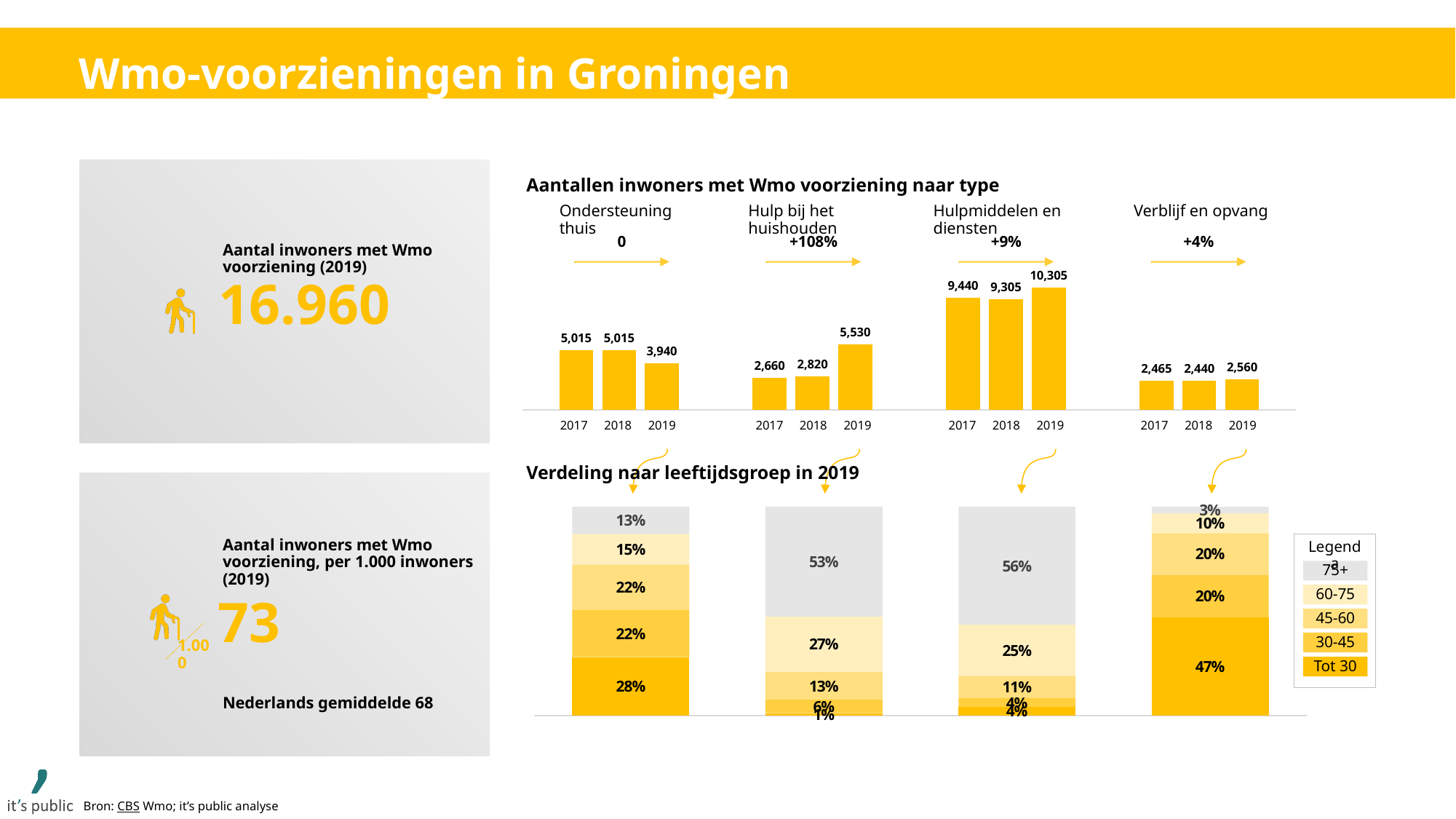
How many age groups does the legend of the 'Verdeling naar leeftijdsgroep in 2019' chart list? 5 In the 'Aantallen inwoners met Wmo voorziening naar type' chart, do the values for Ondersteuning thuis rise or fall from 2017 to 2019? fall In the 'Aantallen inwoners met Wmo voorziening naar type' chart, which year has the lowest value for Verblijf en opvang? 2018 In the 'Aantallen inwoners met Wmo voorziening naar type' chart, which is larger in 2019: Ondersteuning thuis or Hulp bij het huishouden? Hulp bij het huishouden In the 'Aantallen inwoners met Wmo voorziening naar type' chart, what is the value for Hulpmiddelen en diensten in 2019? 10,305 What kind of chart is 'Aantallen inwoners met Wmo voorziening naar type'? bar chart In the 'Aantallen inwoners met Wmo voorziening naar type' chart, what is the difference between the 2019 and 2017 values for Hulp bij het huishouden? 2,870 In the 'Aantallen inwoners met Wmo voorziening naar type' chart, what is the value for Hulp bij het huishouden in 2017? 2,660 In the 'Verdeling naar leeftijdsgroep in 2019' chart, what share of the Verblijf en opvang bar is the Tot 30 age group? 47% In the 'Aantallen inwoners met Wmo voorziening naar type' chart, what percentage change is shown above Hulp bij het huishouden? +108% In the 'Aantallen inwoners met Wmo voorziening naar type' chart, which type has the highest value in 2019? Hulpmiddelen en diensten In the 'Verdeling naar leeftijdsgroep in 2019' chart, what share of the Hulpmiddelen en diensten bar is the 75+ age group? 56%